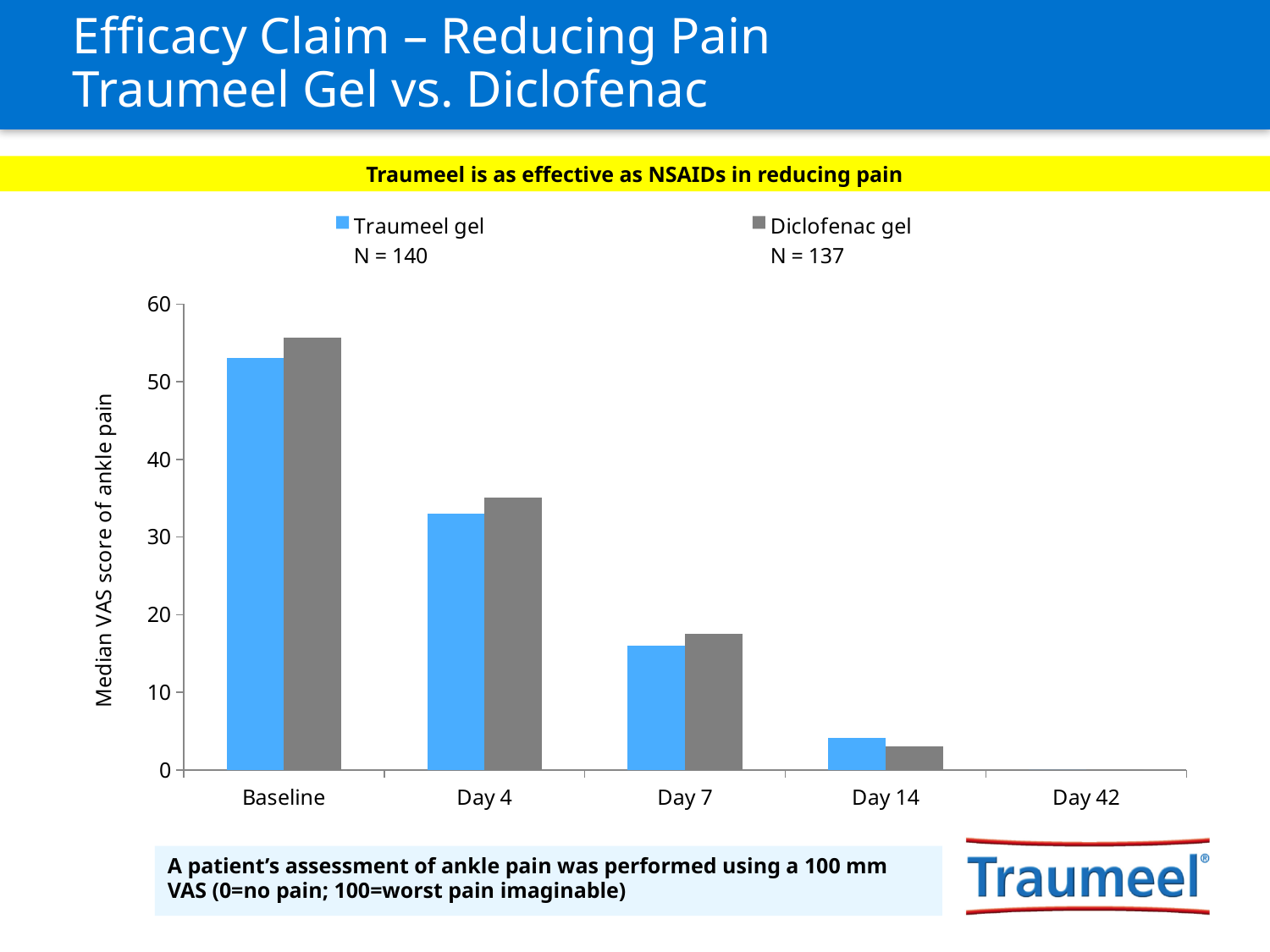
How many time-point categories are shown on the x axis? 5 Is the Diclofenac gel value at Day 14 greater or less than 10? less How many series does the legend list? 2 Is the Traumeel gel value at Baseline greater or less than 50? greater At Day 4, which series has the larger value, Traumeel gel or Diclofenac gel? Diclofenac gel What is the N shown in the legend for Traumeel gel? N = 140 Is the Traumeel gel value at Day 7 greater or less than 20? less At which time point is the Traumeel gel value highest? Baseline What kind of chart is shown on the slide? Bar chart Do the median VAS scores rise or fall from Baseline to Day 42? Fall At which time point is the Diclofenac gel value highest? Baseline